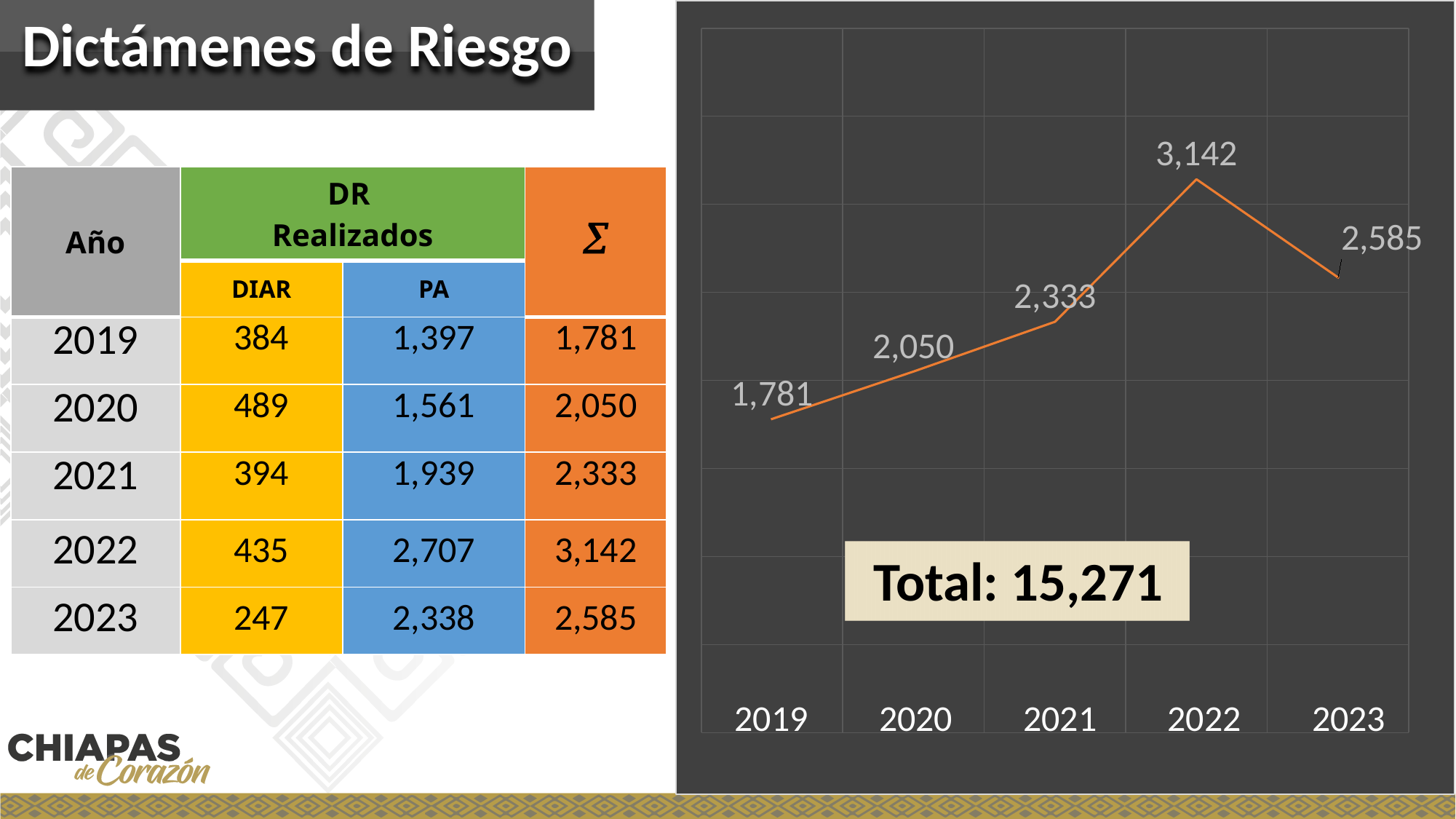
Which is larger, the value for 2021 or the value for 2023? 2023 Which year has the lowest value on the chart? 2019 What is the value plotted for 2021? 2,333 What type of chart is shown on the slide? line chart What total is shown in the box on the chart? 15,271 Does the line rise or fall from 2019 to 2022? rise What is the difference between the values for 2020 and 2019? 269 What is the difference between the values for 2022 and 2023? 557 What is the value plotted for 2019? 1,781 Which year has the highest value on the chart? 2022 How many years are plotted on the chart? 5 What is the value plotted for 2023? 2,585